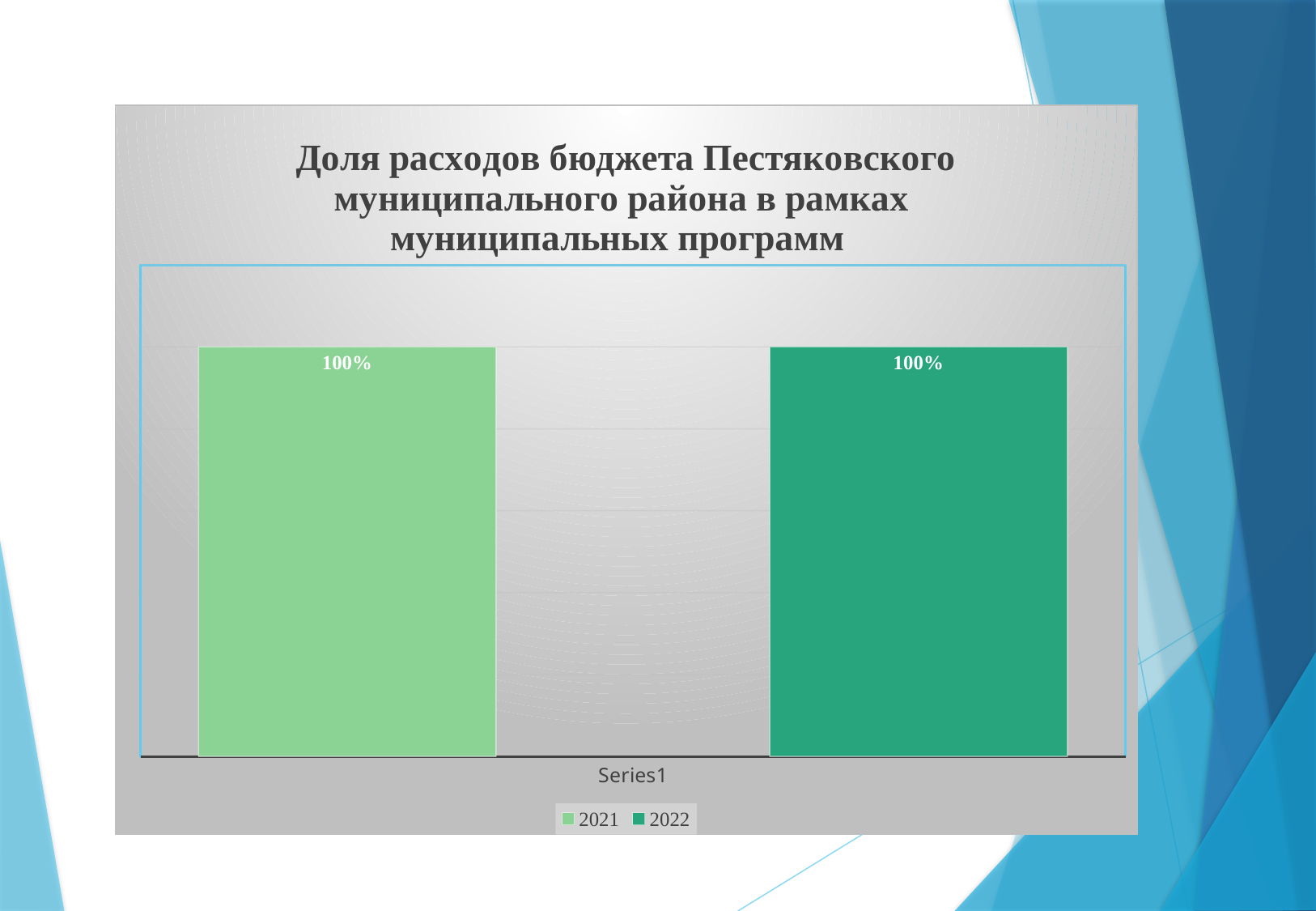
How many series does the legend list? 2 Does the value change from 2021 to 2022? No, it stays at 100% What is the value for 2022? 100% Which series is shown in the darker green colour? 2022 How many bars are plotted on the chart? 2 What is the category label shown on the x axis? Series1 What is the value for 2021? 100% What kind of chart is shown? bar chart What is the difference between the values for 2021 and 2022? 0%